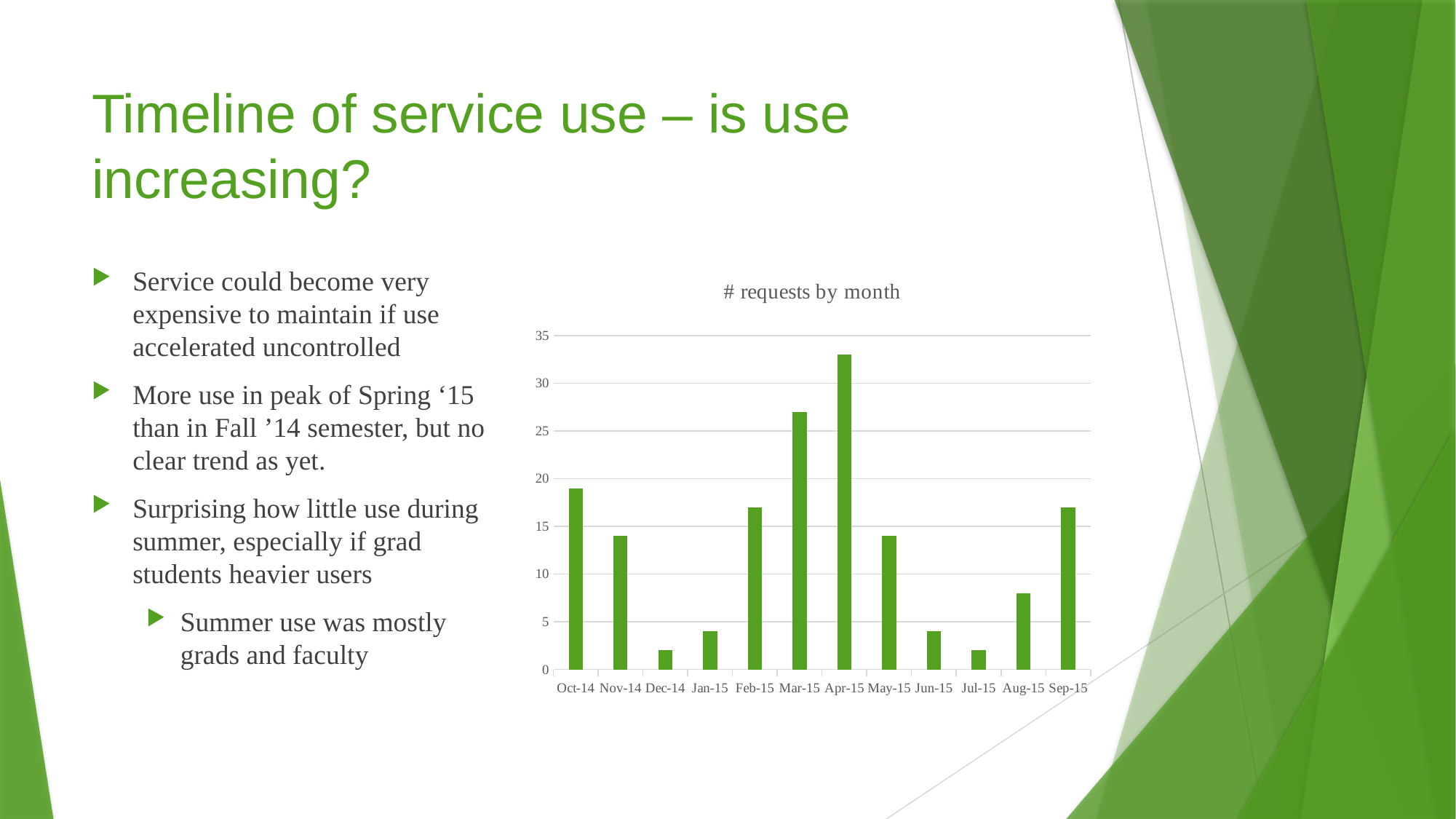
Is the value for Oct-14 greater or less than 15? greater Do the values rise or fall from Jan-15 to Apr-15? rise Which month has the highest number of requests? Apr-15 Is the value for Dec-14 greater or less than 5? less How many months are plotted on the x axis of the chart? 12 Is the value for Apr-15 greater or less than 30? greater Which is larger, the value for Nov-14 or the value for Jun-15? Nov-14 Which is larger, the value for Mar-15 or the value for Oct-14? Mar-15 What is the title of the chart? # requests by month What kind of chart is shown on the slide? bar chart